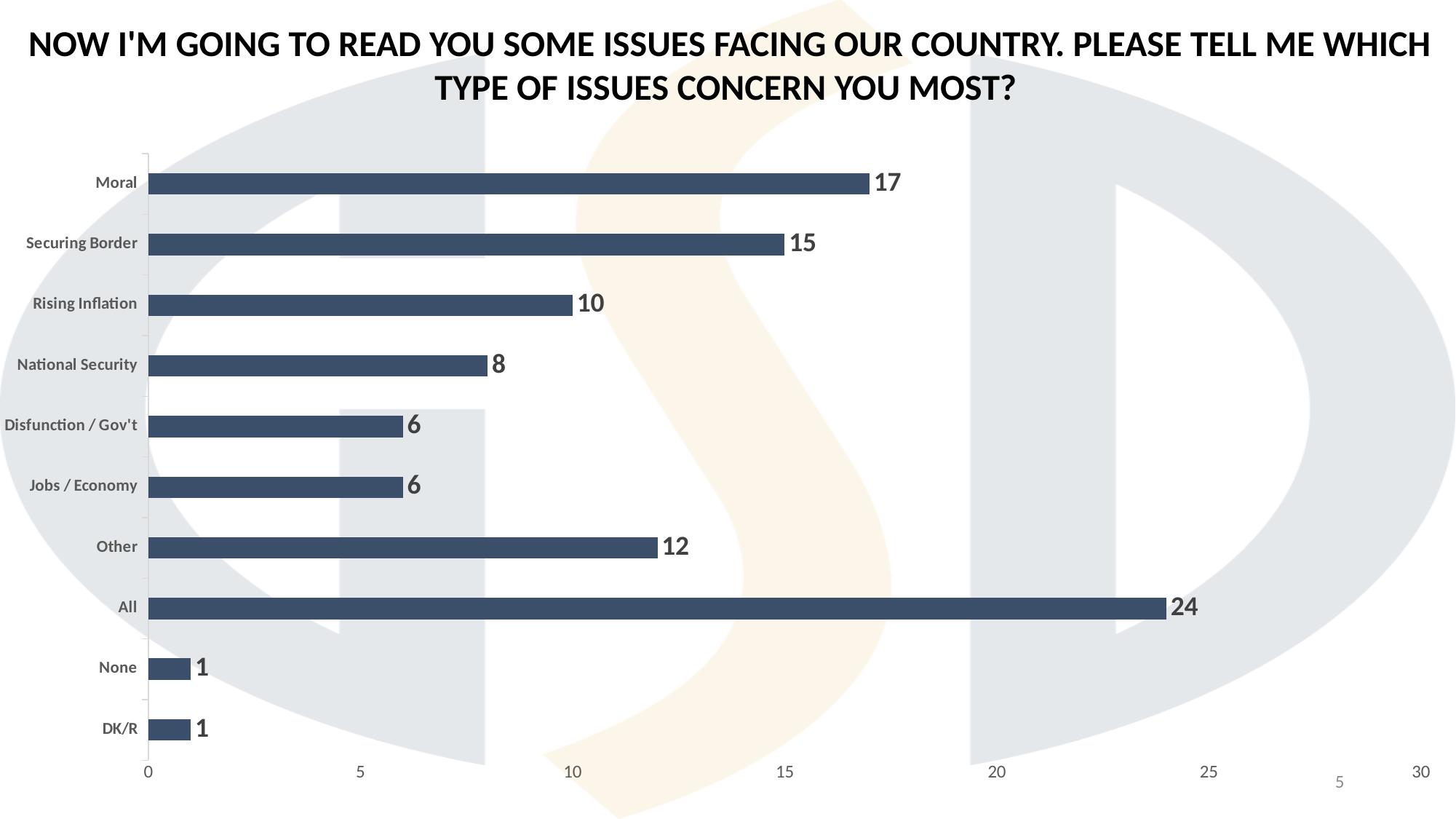
What is the difference between the values for All and Moral? 7 What is the value for Rising Inflation? 10 What is the value for Securing Border? 15 What is the difference between the values for Securing Border and National Security? 7 Which is larger, the value for Rising Inflation or the value for Other? Other Is the value for All greater or less than 20? greater Which two categories both have a value of 6? Disfunction / Gov't and Jobs / Economy How many categories are shown on the chart? 10 What is the value for Moral? 17 Which category has the highest value? All What kind of chart is shown on the slide? bar chart What is the value for Other? 12